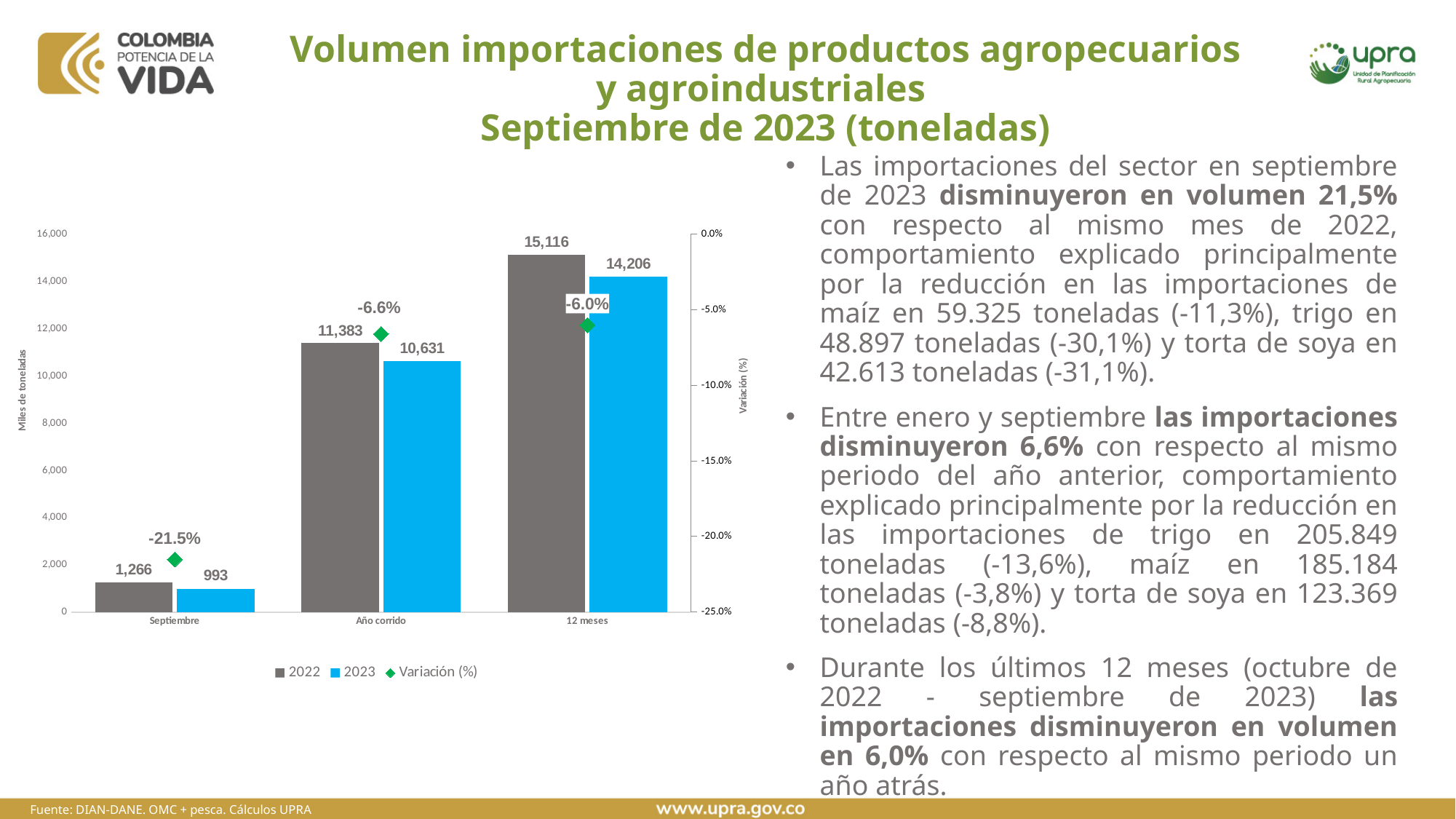
Which category has the lowest 2022 value? Septiembre What is the 2022 value for 12 meses? 15,116 What is the 2023 value for Año corrido? 10,631 Which category has the highest 2023 value? 12 meses What is the label of the left vertical axis? Miles de toneladas What is the Variación (%) value for Septiembre? -21.5% What is the 2022 value for Septiembre? 1,266 How many series does the legend list? 3 What kind of chart is this? Bar chart with a line/marker series What is the difference between the 2022 and 2023 values for 12 meses? 910 Which is larger for Año corrido, the 2022 value or the 2023 value? 2022 How many categories are shown on the x axis? 3